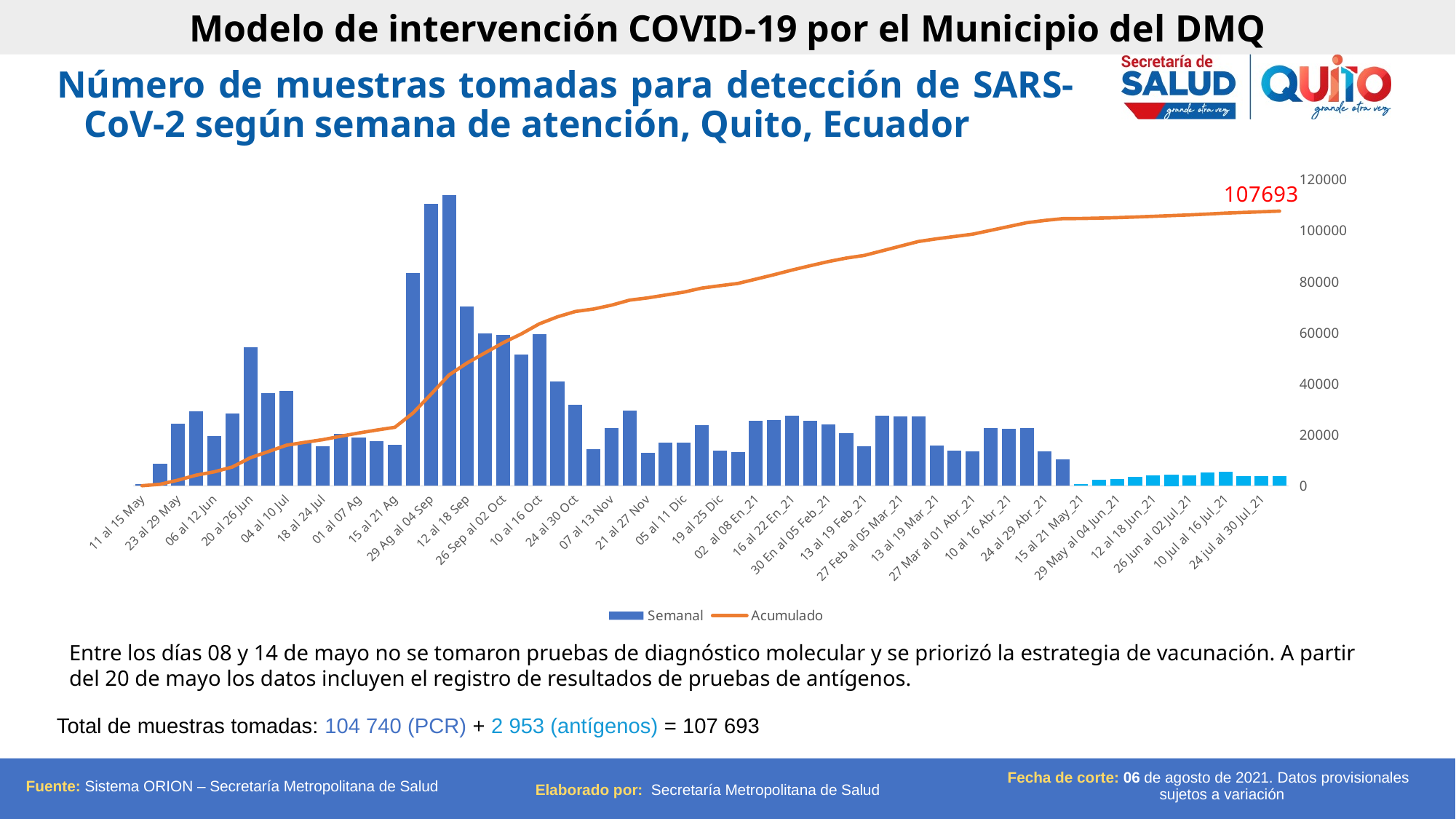
Do the Semanal bars rise or fall between '12 al 18 Sep' and '07 al 13 Nov'? Fall What are the two series named in the legend? Semanal and Acumulado How many series does the legend list? 2 Is the Acumulado value at '24 al 30 Oct' greater or less than 60000? greater Is the Acumulado value at '11 al 15 May' greater or less than 20000? less What kind of chart is shown on the slide? A combined bar and line chart Is the Acumulado value at '12 al 18 Sep' greater or less than 40000? greater Does the Acumulado line rise or fall along the x axis? Rises What is the final value labelled on the Acumulado line? 107693 What colour is the Acumulado line? Orange Which is larger, the Acumulado value at '12 al 18 Sep' or at '24 al 30 Oct'? 24 al 30 Oct